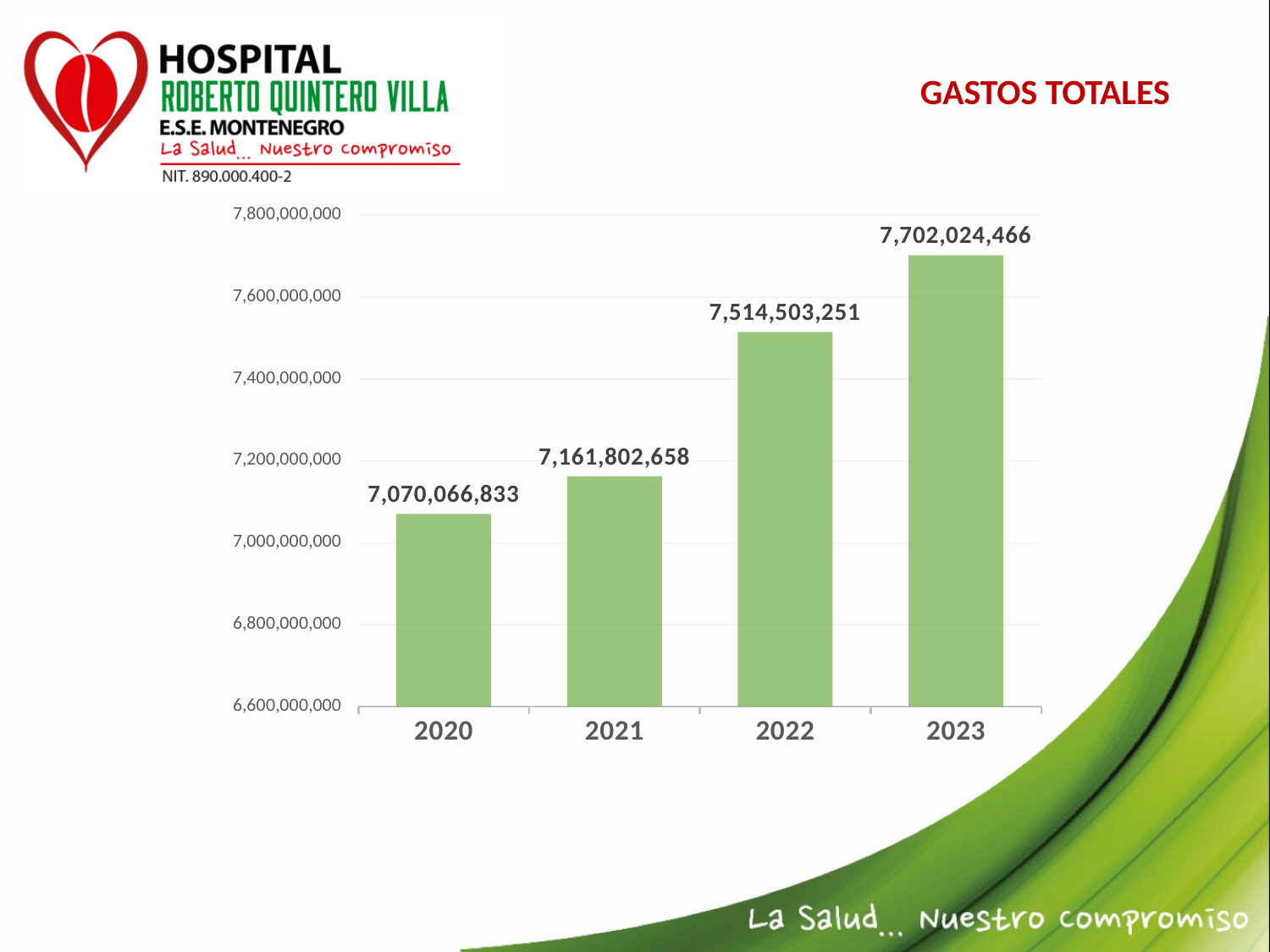
What is the value shown for 2022? 7,514,503,251 How many years are shown on the x axis? 4 What is the value shown for 2021? 7,161,802,658 Is the value for 2022 greater or less than 7,400,000,000? greater What is the difference between the values for 2021 and 2020? 91,735,825 What is the value shown for 2020? 7,070,066,833 Which year has the highest value? 2023 What is the difference between the values for 2023 and 2022? 187,521,215 Which year has the lowest value? 2020 Which is larger, the value for 2021 or the value for 2022? 2022 What kind of chart is shown on the slide? bar chart What is the value shown for 2023? 7,702,024,466